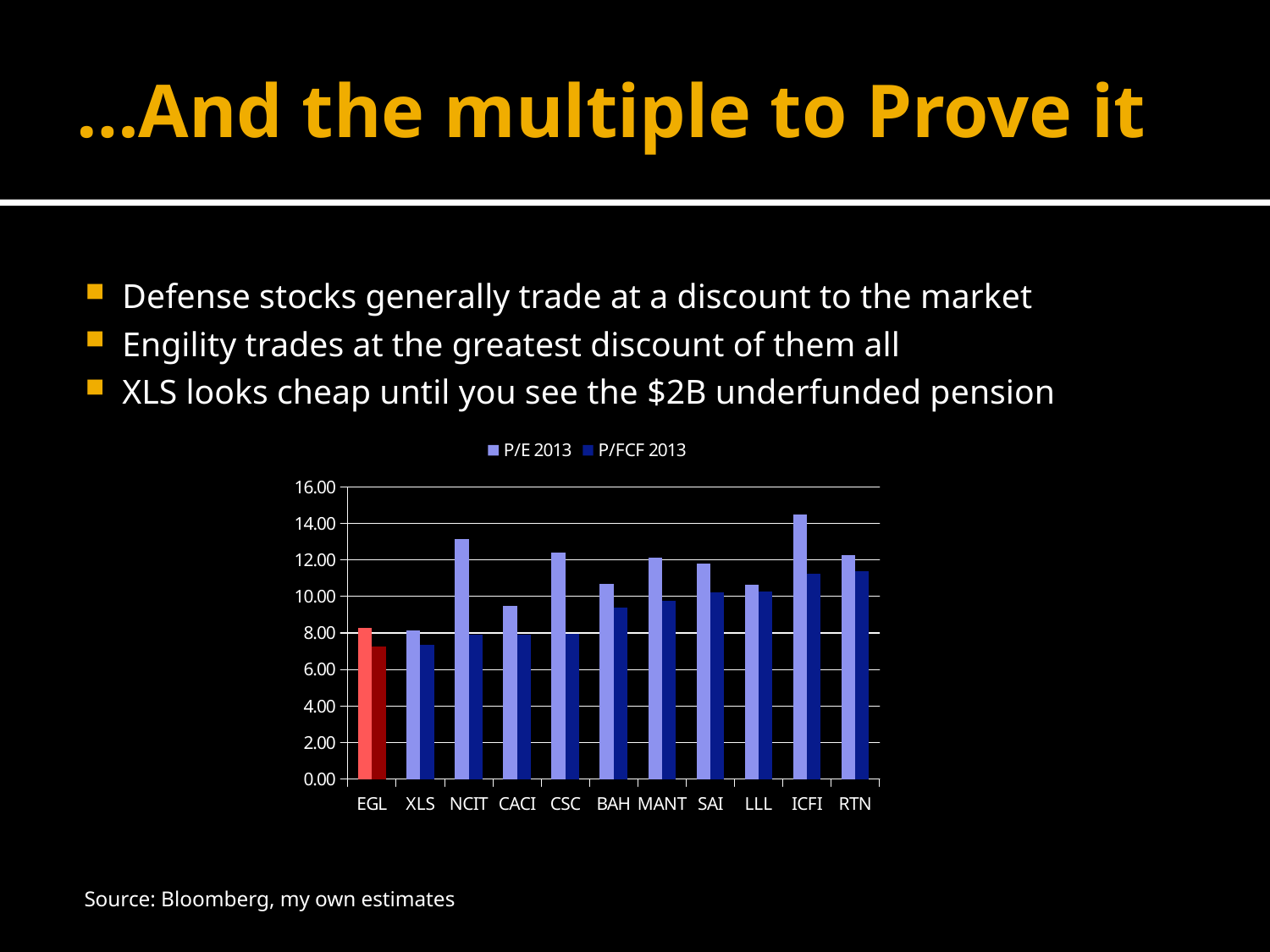
Which is larger, the P/E 2013 value for NCIT or the P/E 2013 value for CACI? NCIT Is the P/FCF 2013 value for EGL greater or less than 8.00? less Is the P/E 2013 value for NCIT greater or less than 12.00? greater Is the P/E 2013 value for ICFI greater or less than 14.00? greater Which is larger, the P/FCF 2013 value for ICFI or the P/FCF 2013 value for BAH? ICFI Which company has the highest P/E 2013 value in the chart? ICFI How many companies (categories) are shown on the x axis of the chart? 11 How many series does the chart's legend list? 2 Which company's bars are coloured red instead of blue in the chart? EGL What kind of chart is shown on the slide? bar chart